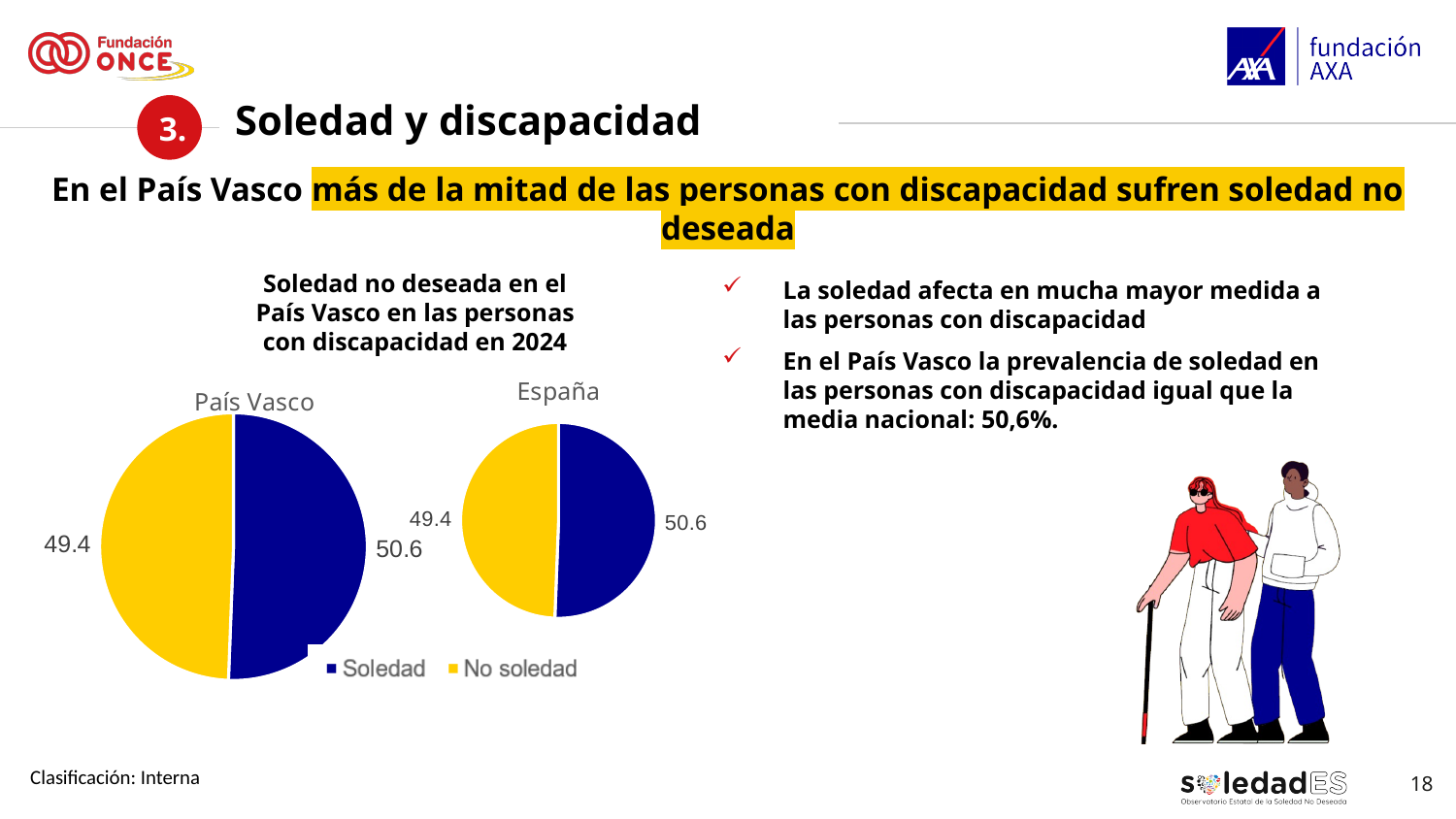
In the España pie chart, what is the value for No soledad? 49.4 How many entries does the legend list for the pie charts? 2 In the País Vasco pie chart, what is the value for Soledad? 50.6 In the España pie chart, which slice is the smallest? No soledad In the País Vasco pie chart, which slice is larger, Soledad or No soledad? Soledad How many slices does the España pie chart have? 2 In the País Vasco pie chart, what is the difference between the Soledad and No soledad values? 1.2 What type of chart is used to show the País Vasco and España data? Pie chart In the España pie chart, what is the value for Soledad? 50.6 In the pie charts, which colour represents No soledad? Yellow In the País Vasco pie chart, what is the value for No soledad? 49.4 What is the title of the chart on the slide? Soledad no deseada en el País Vasco en las personas con discapacidad en 2024